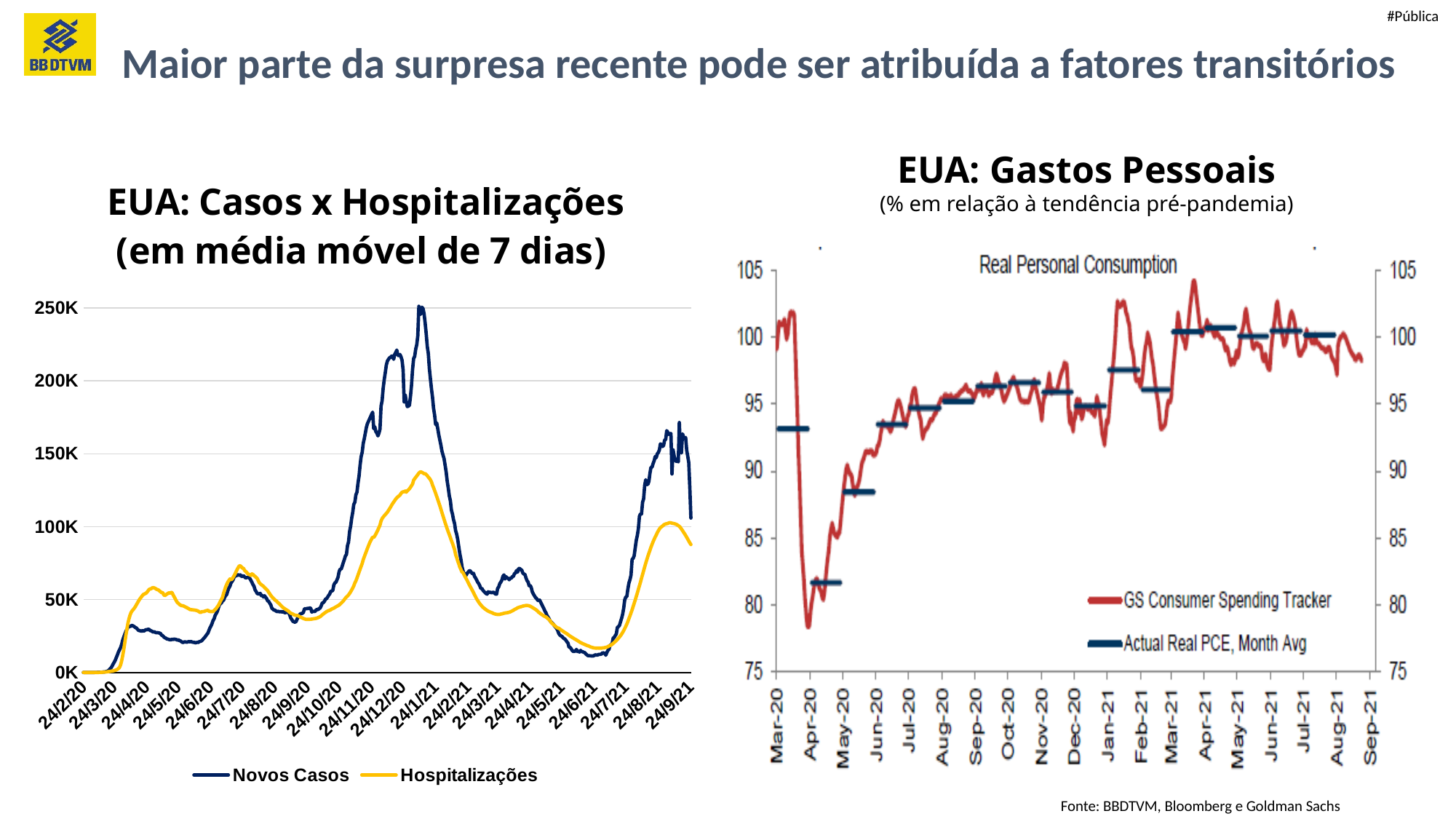
In 'EUA: Casos x Hospitalizações', which colour is the Hospitalizações line? yellow In 'EUA: Gastos Pessoais', is the lowest value of the GS Consumer Spending Tracker in Apr-20 greater or less than 80? less What kind of chart is 'EUA: Casos x Hospitalizações'? line chart In 'EUA: Casos x Hospitalizações', which series is higher at 24/1/21, Novos Casos or Hospitalizações? Novos Casos In 'EUA: Casos x Hospitalizações', is the value of Novos Casos at 24/6/21 greater or less than 50K? less In 'EUA: Casos x Hospitalizações', is the peak value of Novos Casos around 24/1/21 greater or less than 200K? greater How many series does the legend of 'EUA: Casos x Hospitalizações' list? 2 What kind of chart is 'EUA: Gastos Pessoais'? line chart How many series does the legend of 'EUA: Gastos Pessoais' list? 2 In 'EUA: Gastos Pessoais', does the GS Consumer Spending Tracker rise or fall between Apr-20 and Mar-21? rise